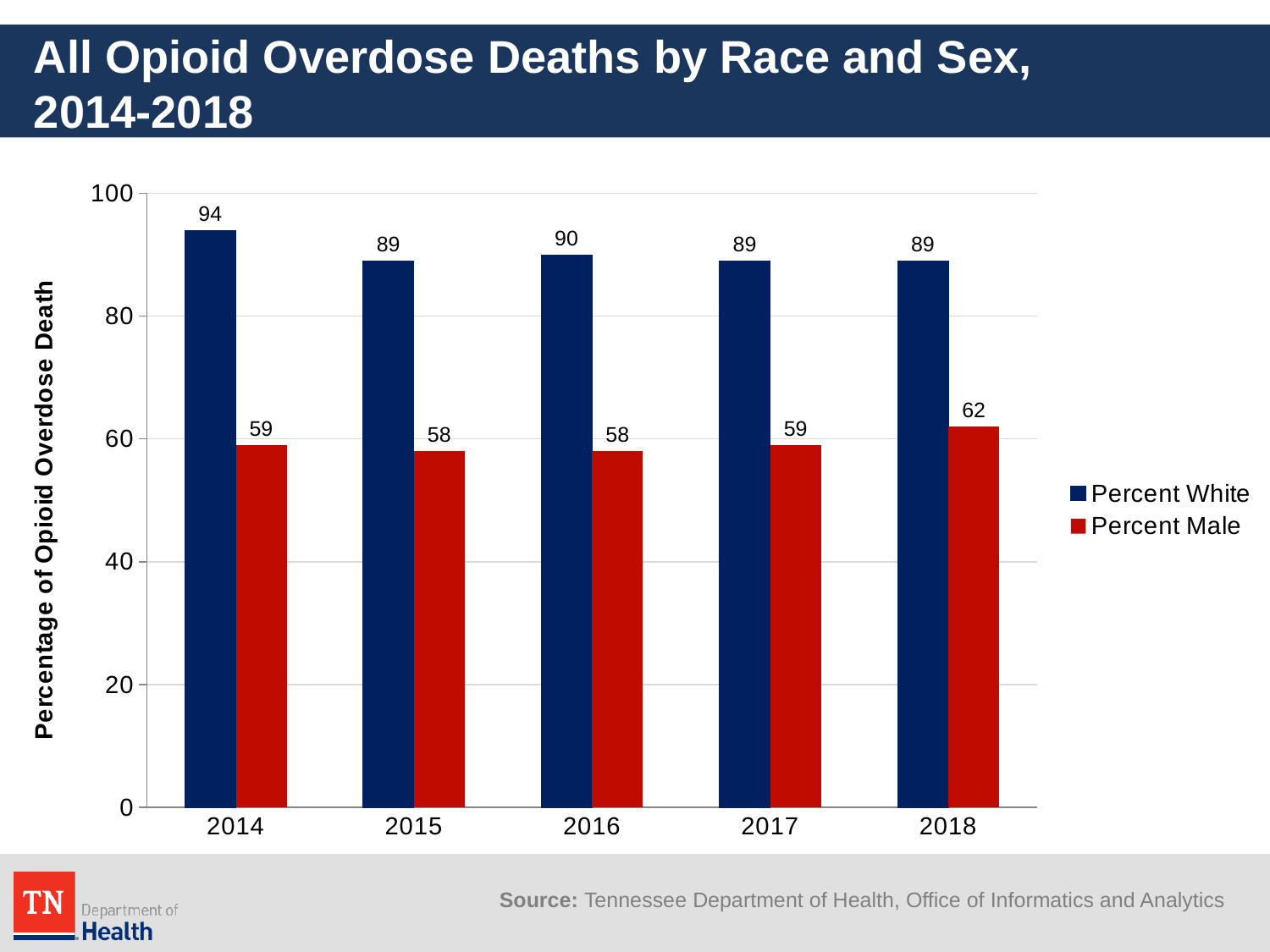
What is the Percent Male value for 2018? 62 How many years are shown on the x axis? 5 Is the Percent Male value for 2018 greater or less than 60? greater Which is larger in 2017, Percent White or Percent Male? Percent White What is the Percent White value for 2014? 94 What is the difference between Percent White and Percent Male in 2014? 35 What kind of chart is shown on the slide? Bar chart How many series does the legend list? 2 What is the difference between the Percent Male values for 2018 and 2015? 4 Which year has the highest Percent Male value? 2018 What is the Percent Male value for 2016? 58 Which year has the highest Percent White value? 2014